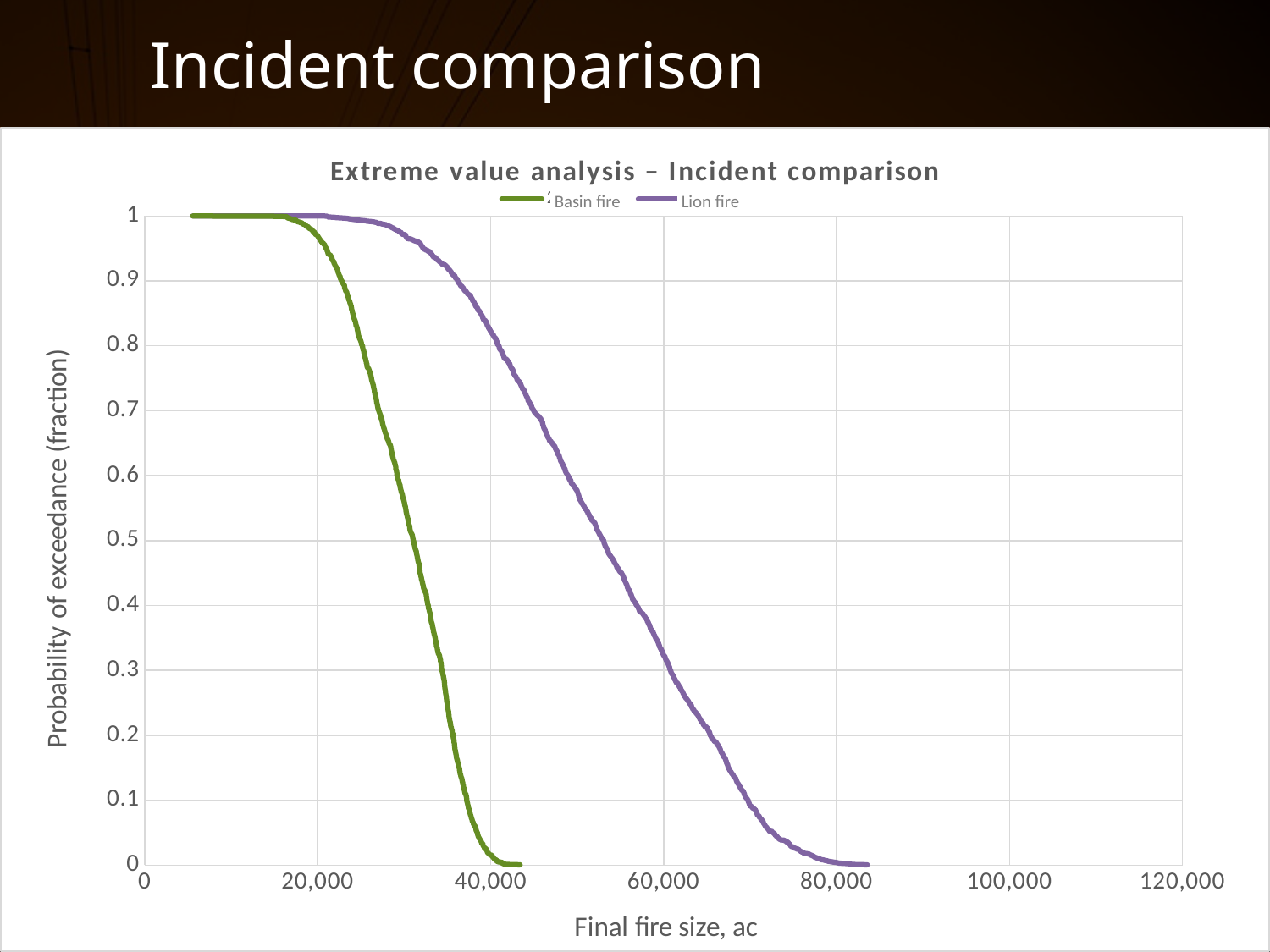
How many series does the legend list? 2 Is the probability of exceedance for the Lion fire at 40,000 ac greater or less than 0.8? greater Is the probability of exceedance for the Basin fire at 20,000 ac greater or less than 0.9? greater What kind of chart is shown on the slide? Line chart What is the title of the chart? Extreme value analysis – Incident comparison Is the probability of exceedance for the Lion fire at 60,000 ac greater or less than 0.5? less Does the probability of exceedance for the Lion fire rise or fall as final fire size increases? Fall Does the probability of exceedance for the Basin fire rise or fall as final fire size increases? Fall What is the label of the x axis? Final fire size, ac At a final fire size of 40,000 ac, which series has the higher probability of exceedance, Basin fire or Lion fire? Lion fire